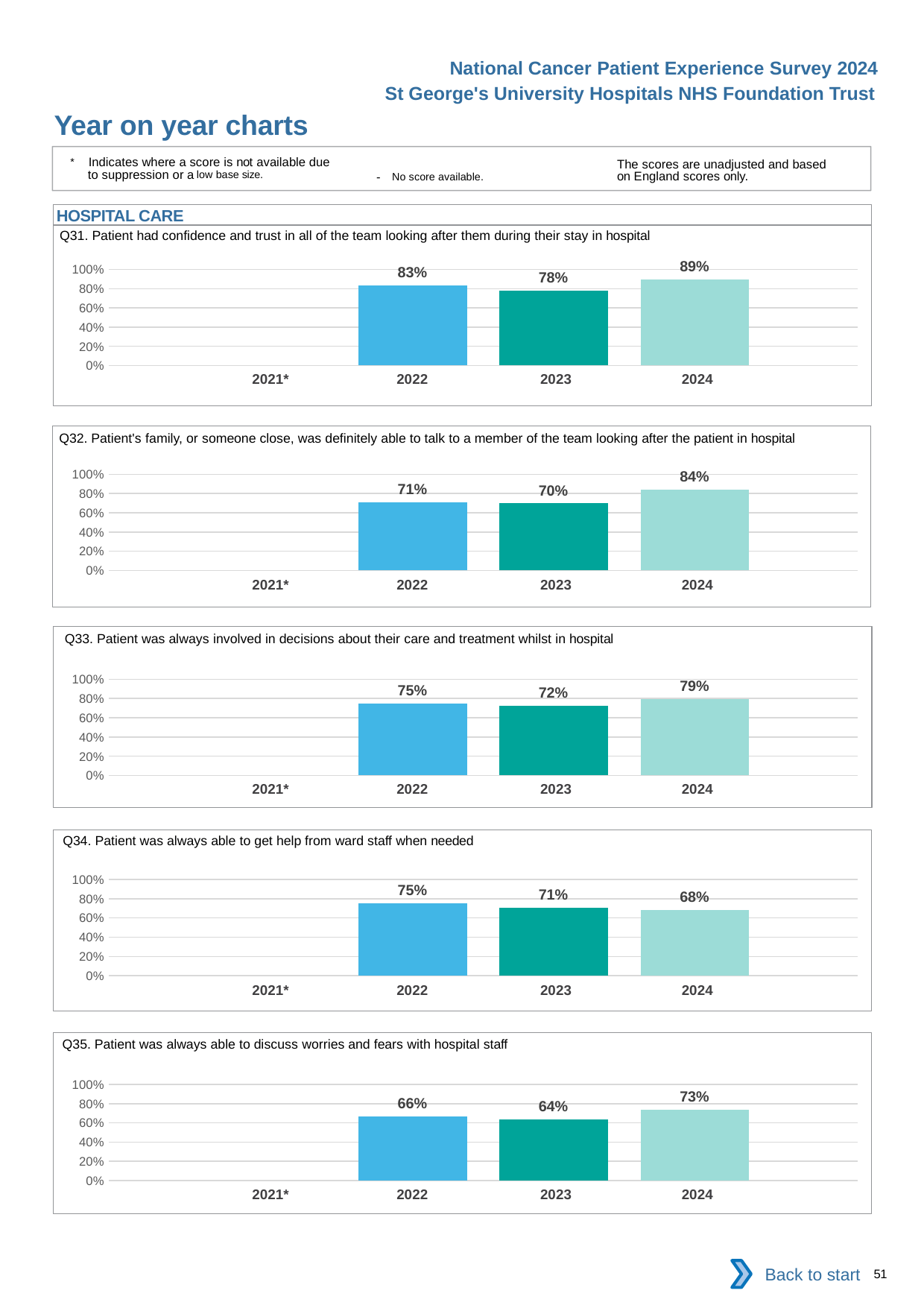
In the Q31 chart, what is the value for 2024? 89% In the Q35 chart, how many years have a bar plotted? 3 In the Q32 chart, which year has the highest value? 2024 In the Q34 chart, do the values rise or fall from 2022 to 2024? fall What kind of chart is the Q33 chart? bar chart In the Q35 chart, what is the value for 2022? 66% In the Q31 chart, which is larger, the value for 2022 or the value for 2023? 2022 In the Q34 chart, which year has the lowest value? 2024 In the Q33 chart, what is the value for 2022? 75% In the Q32 chart, what is the difference between the 2024 and 2022 values? 13% In the Q31 chart, which year is marked with an asterisk indicating no score is available? 2021* In the Q33 chart, what is the difference between the 2024 and 2023 values? 7%